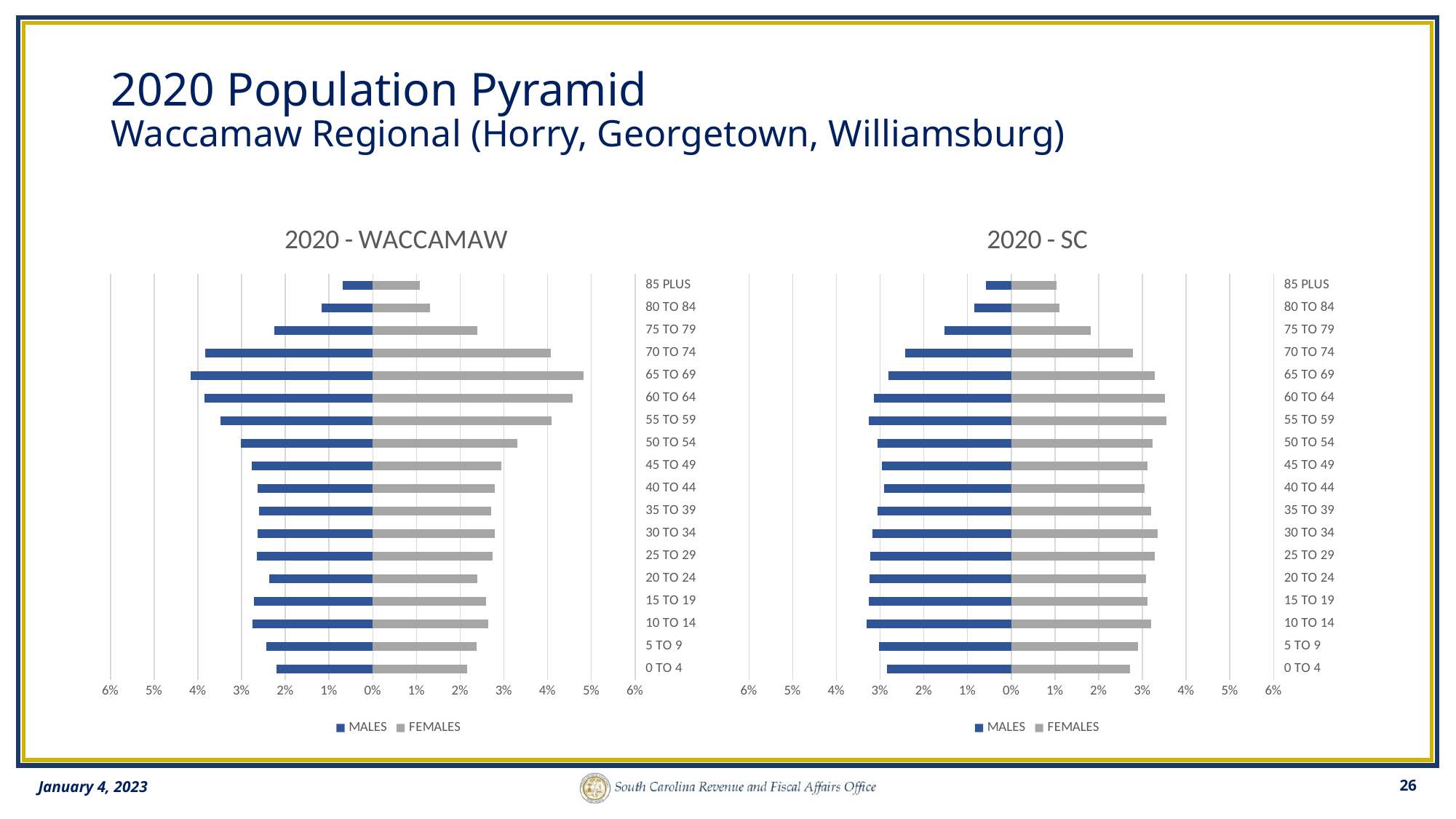
In the 2020 - WACCAMAW chart, is the FEMALES value for 65 TO 69 greater or less than 4%? greater How many age-group categories are shown on the 2020 - WACCAMAW chart? 18 How many series does the legend of the 2020 - SC chart list? 2 In the 2020 - SC chart, which age group has the lowest MALES value? 85 PLUS In the 2020 - WACCAMAW chart, which age group has the lowest MALES value? 85 PLUS In the 2020 - SC chart, is the FEMALES value for 55 TO 59 greater or less than 3%? greater In the 2020 - WACCAMAW chart, which age group has the highest MALES value? 65 TO 69 In the 2020 - WACCAMAW chart, is the MALES value for 85 PLUS greater or less than 1%? less In the 2020 - WACCAMAW chart, which is larger: the FEMALES value for 65 TO 69 or the FEMALES value for 0 TO 4? 65 TO 69 In the 2020 - SC chart, which colour represents MALES? Blue What kind of chart is the 2020 - WACCAMAW chart? Bar chart In the 2020 - WACCAMAW chart, which age group has the highest FEMALES value? 65 TO 69